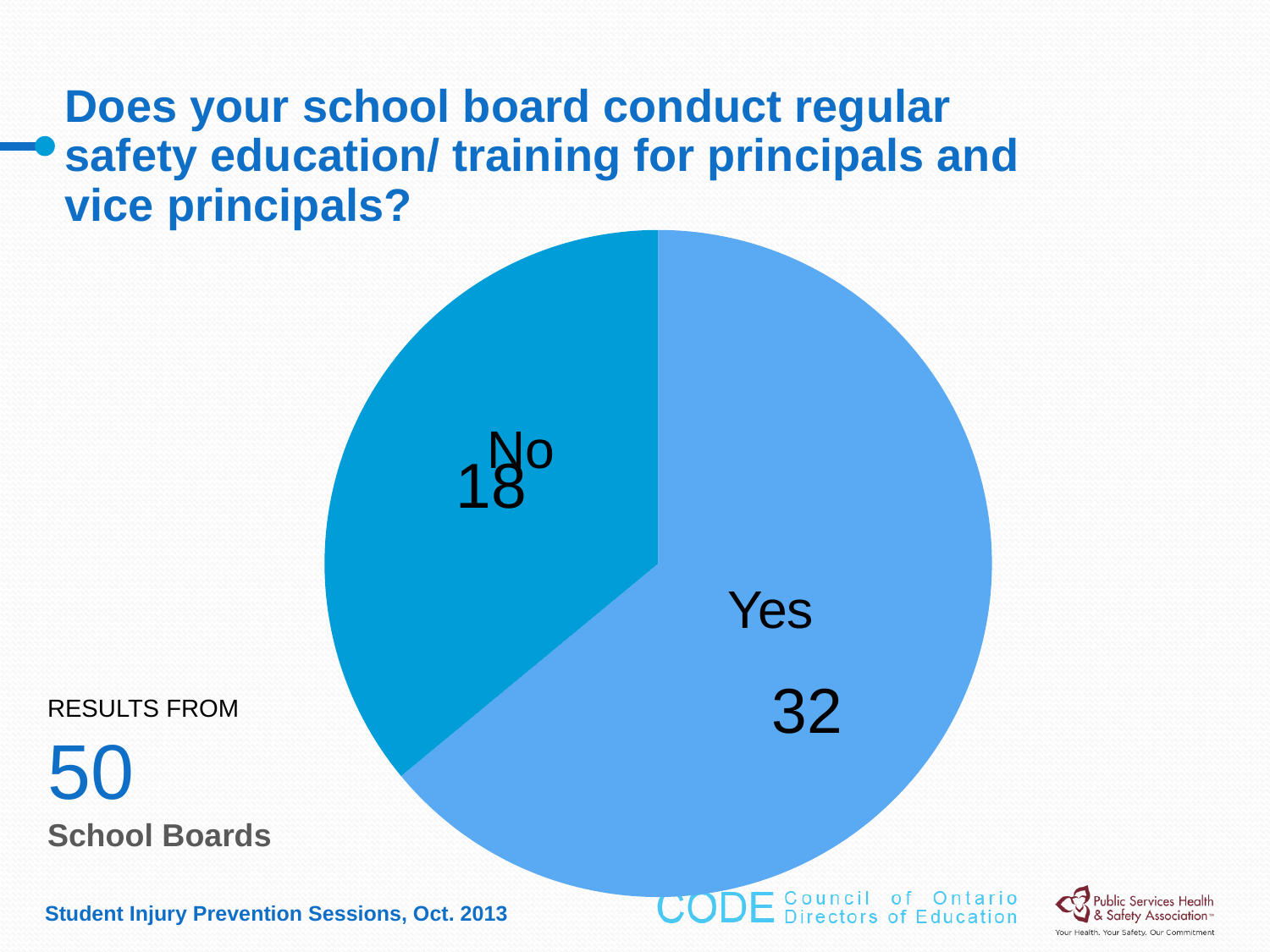
What is the value for the "Yes" slice? 32 What is the value for the "No" slice? 18 What is the difference between the "Yes" and "No" values? 14 Which slice is the smallest? No Which slice is the largest? Yes What share of the pie does the "No" slice represent? 36% How many slices does the pie chart have? 2 Which is larger, the "Yes" slice or the "No" slice? Yes What kind of chart is shown on the slide? pie chart What is the total of the two slices in the pie chart? 50 What share of the pie does the "Yes" slice represent? 64% How many school boards do the results come from, according to the slide? 50